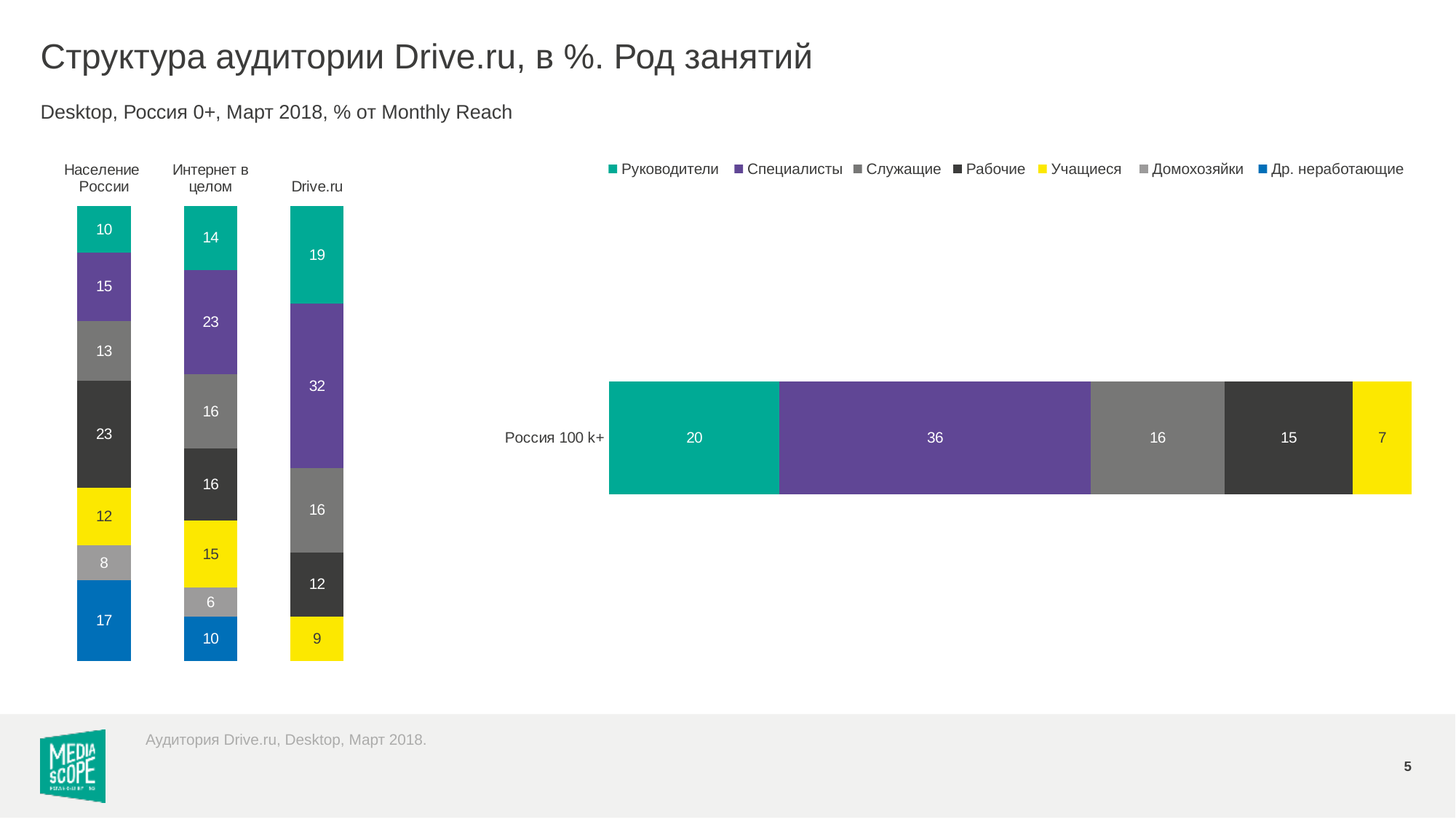
In the left chart, what is the value for Др. неработающие in the Интернет в целом bar? 10 In the left chart, which is larger: Учащиеся for Интернет в целом or Учащиеся for Drive.ru? Интернет в целом How many series does the legend list? 7 In the left chart, what is the value for Специалисты in the Drive.ru bar? 32 In the left chart, what is the value for Рабочие in the Население России bar? 23 In the left chart, what is the difference between the Руководители values for Drive.ru and Население России? 9 In the right chart, what is the total of the Россия 100 k+ bar? 94 What kind of chart is the right chart (Россия 100 k+)? Stacked bar chart In the right chart (Россия 100 k+), what is the value for Специалисты? 36 In the right chart (Россия 100 k+), which occupation group has the lowest value? Учащиеся In the left chart, which occupation group has the highest value in the Drive.ru bar? Специалисты How many bars does the left chart show? 3